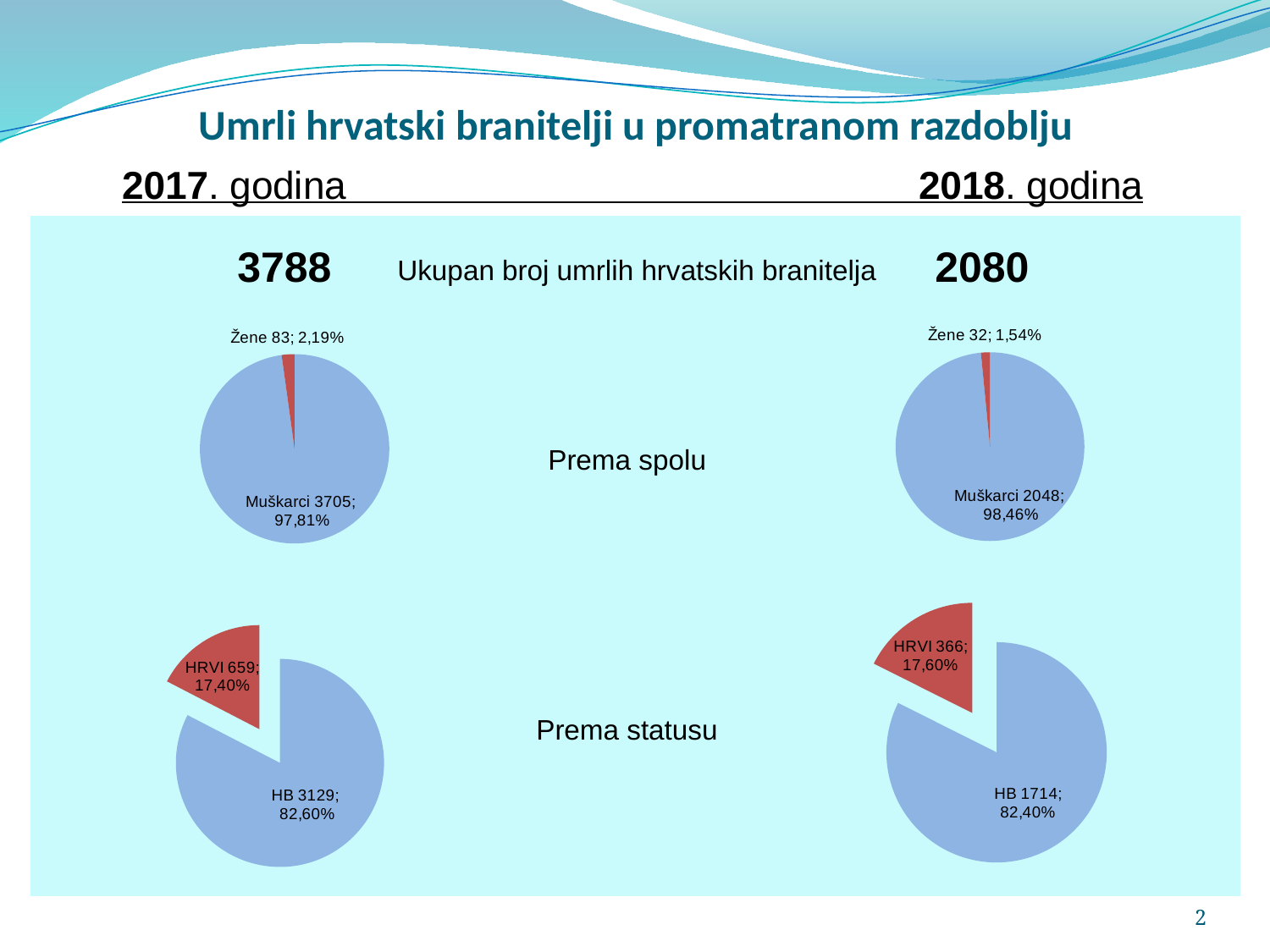
Which is larger: the HRVI count in the 2017 'Prema statusu' chart or the HRVI count in the 2018 'Prema statusu' chart? 2017 (659) In the 2017 'Prema spolu' pie chart (top left), what is the value for Žene? 83; 2,19% In the 2018 'Prema statusu' pie chart (bottom right), which category is the smallest? HRVI In the 2017 'Prema spolu' pie chart (top left), which category is the largest? Muškarci In the 2017 'Prema statusu' pie chart (bottom left), what share of the pie does HB have? 82,60% In the 2018 'Prema spolu' pie chart (top right), what is the value for Muškarci? 2048; 98,46% In the 2017 'Prema spolu' pie chart (top left), what is the difference between the Muškarci and Žene counts? 3622 In the 2018 'Prema spolu' pie chart (top right), what share of the pie does Žene have? 1,54% In the 2018 'Prema statusu' pie chart (bottom right), what is the value for HB? 1714; 82,40% What type of chart is used for the 'Prema spolu' data on this slide? Pie chart In the 2017 'Prema statusu' pie chart (bottom left), what is the value for HRVI? 659; 17,40% How many slices does the 2018 'Prema statusu' pie chart (bottom right) have? 2